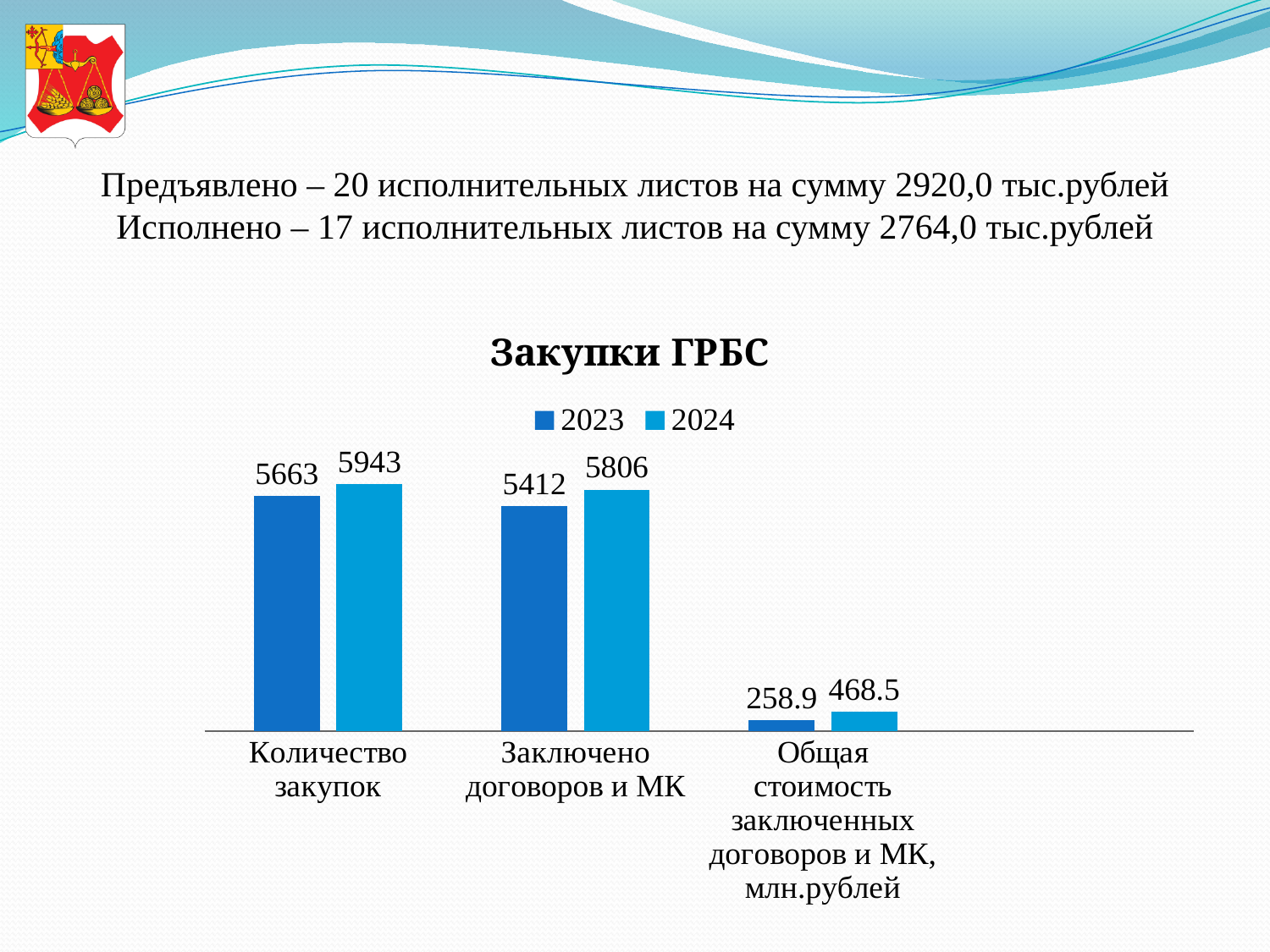
How many categories are shown on the x axis? 3 What is the difference between the 2024 and 2023 values for "Заключено договоров и МК"? 394 How many series does the legend list? 2 What is the 2023 value for "Общая стоимость заключенных договоров и МК, млн.рублей"? 258.9 What is the value for 2024 in the "Количество закупок" category? 5943 What is the title of the chart? Закупки ГРБС Which category has the highest 2024 value? Количество закупок What is the 2024 value for "Общая стоимость заключенных договоров и МК, млн.рублей"? 468.5 What is the value for 2023 in the "Заключено договоров и МК" category? 5412 Which is larger for "Общая стоимость заключенных договоров и МК, млн.рублей": the 2023 value or the 2024 value? 2024 Which category has the lowest 2023 value? Общая стоимость заключенных договоров и МК, млн.рублей What is the difference between the 2024 and 2023 values for "Количество закупок"? 280